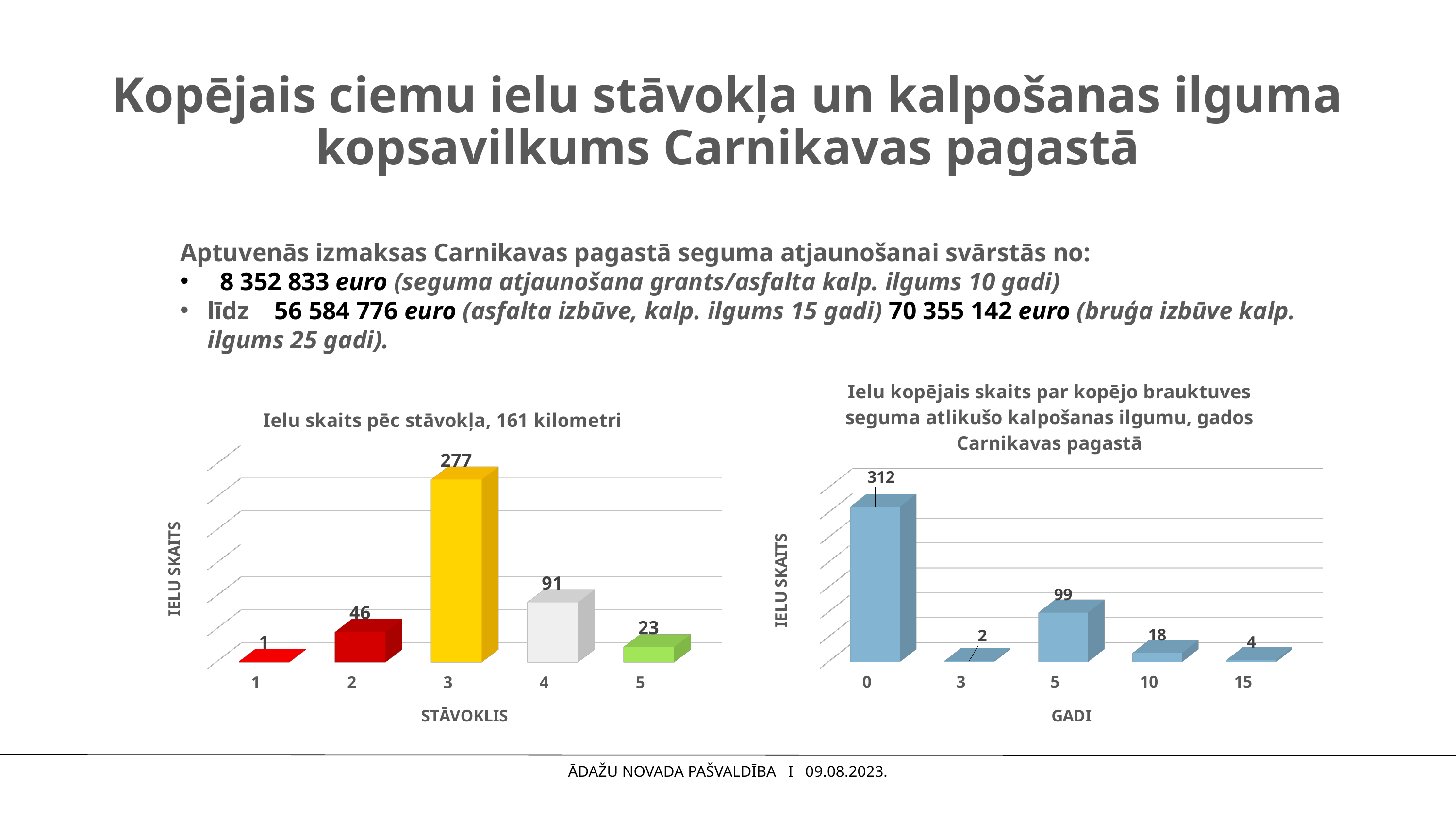
In the right chart 'Ielu kopējais skaits par kopējo brauktuves seguma atlikušo kalpošanas ilgumu, gados Carnikavas pagastā', which gadi category has the lowest value? 3 In the right chart 'Ielu kopējais skaits par kopējo brauktuves seguma atlikušo kalpošanas ilgumu, gados Carnikavas pagastā', what is the value for 10 gadi? 18 In the right chart 'Ielu kopējais skaits par kopējo brauktuves seguma atlikušo kalpošanas ilgumu, gados Carnikavas pagastā', which is larger: the value for 5 gadi or the value for 15 gadi? 5 gadi In the left chart 'Ielu skaits pēc stāvokļa, 161 kilometri', what is the difference between the values for stāvoklis 4 and stāvoklis 2? 45 What kind of chart is the right chart 'Ielu kopējais skaits par kopējo brauktuves seguma atlikušo kalpošanas ilgumu, gados Carnikavas pagastā'? Bar chart In the right chart 'Ielu kopējais skaits par kopējo brauktuves seguma atlikušo kalpošanas ilgumu, gados Carnikavas pagastā', what is the value for 0 gadi? 312 In the left chart 'Ielu skaits pēc stāvokļa, 161 kilometri', how many categories are shown on the x axis? 5 In the right chart 'Ielu kopējais skaits par kopējo brauktuves seguma atlikušo kalpošanas ilgumu, gados Carnikavas pagastā', what is the difference between the values for 0 gadi and 5 gadi? 213 In the left chart 'Ielu skaits pēc stāvokļa, 161 kilometri', which stāvoklis category has the lowest value? 1 In the left chart 'Ielu skaits pēc stāvokļa, 161 kilometri', what is the value for stāvoklis 5? 23 In the left chart 'Ielu skaits pēc stāvokļa, 161 kilometri', which stāvoklis category has the highest value? 3 In the left chart 'Ielu skaits pēc stāvokļa, 161 kilometri', what is the value for stāvoklis 3? 277